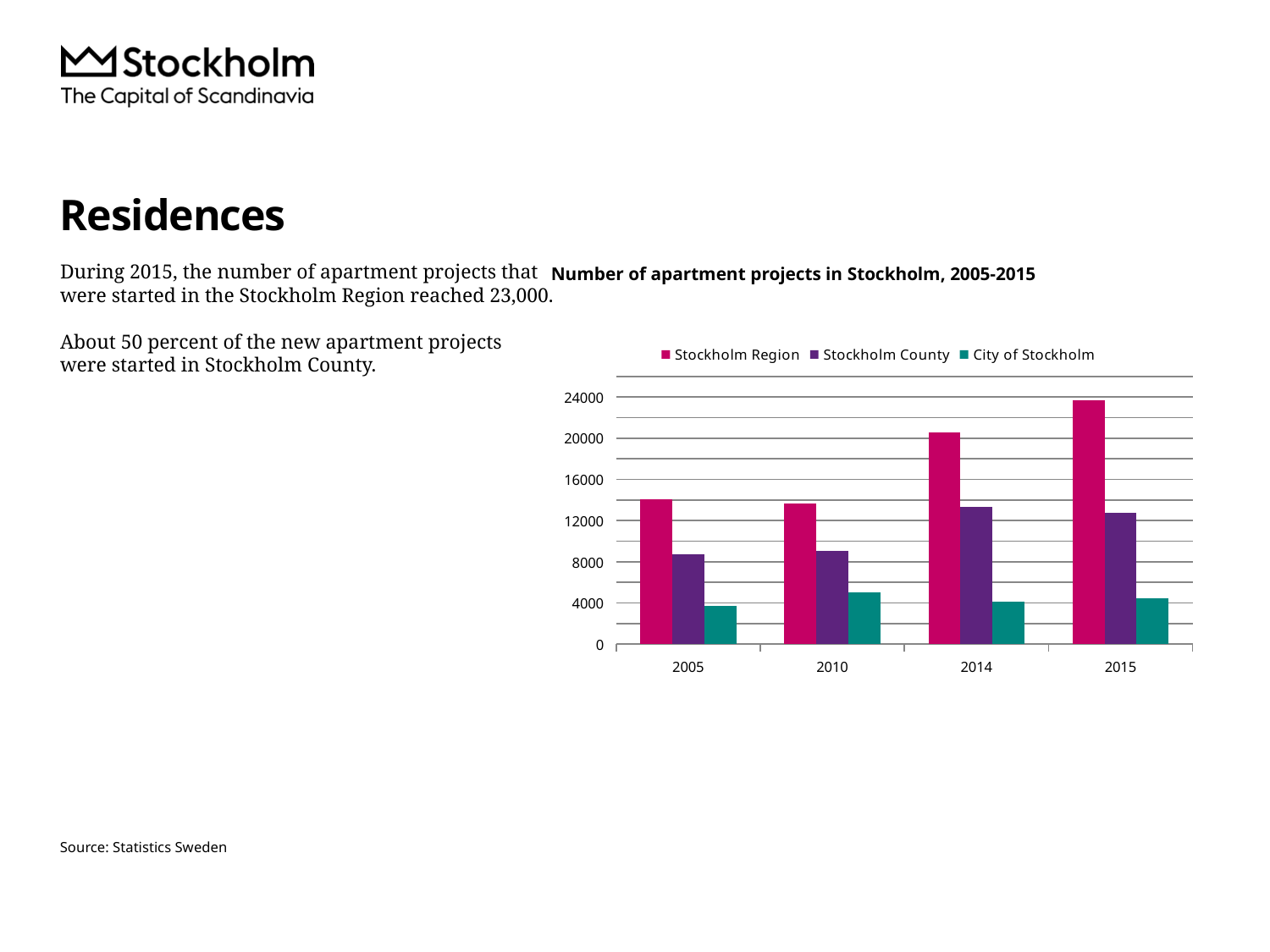
Is the value for Stockholm County in 2010 greater or less than 12000? less Is the value for Stockholm Region in 2014 greater or less than 16000? greater How many years are shown on the x axis of the chart? 4 What is the title of the chart? Number of apartment projects in Stockholm, 2005-2015 How many series does the chart legend list? 3 In which year is the value for City of Stockholm lowest? 2005 What kind of chart is shown on the slide? bar chart Is the value for Stockholm Region in 2015 greater or less than 20000? greater Which is larger in 2014: the value for Stockholm County or the value for City of Stockholm? Stockholm County In which year is the value for City of Stockholm highest? 2010 In which year is the value for Stockholm Region highest? 2015